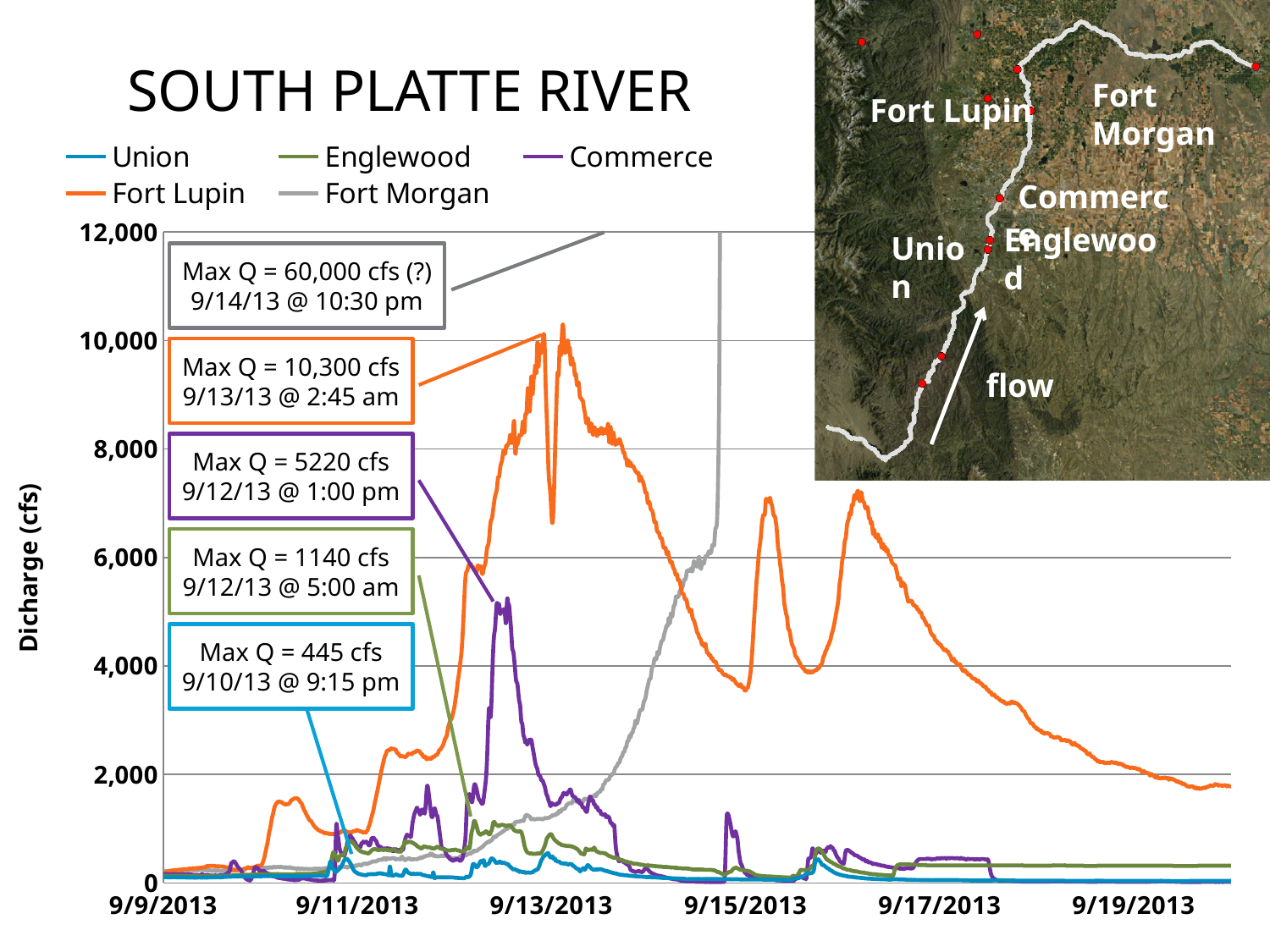
Which station has the lowest annotated maximum discharge? Union What is the difference between the annotated maximum discharge of Fort Lupin and that of Commerce? 5080 cfs How many series does the legend list? 5 Which station has a larger annotated maximum discharge, Englewood or Union? Englewood What is the maximum discharge (Max Q) annotated for Fort Lupin? 10,300 cfs Is the Fort Morgan discharge on 9/15/2013 greater or less than 4,000? greater Which station has the highest annotated maximum discharge? Fort Morgan What is the label on the vertical axis of the chart? Dicharge (cfs) On what date and time did Englewood reach its annotated maximum discharge? 9/12/13 @ 5:00 am What is the maximum discharge (Max Q) annotated for Commerce? 5220 cfs What is the maximum discharge (Max Q) annotated for Union? 445 cfs What kind of chart is shown on the slide? line chart